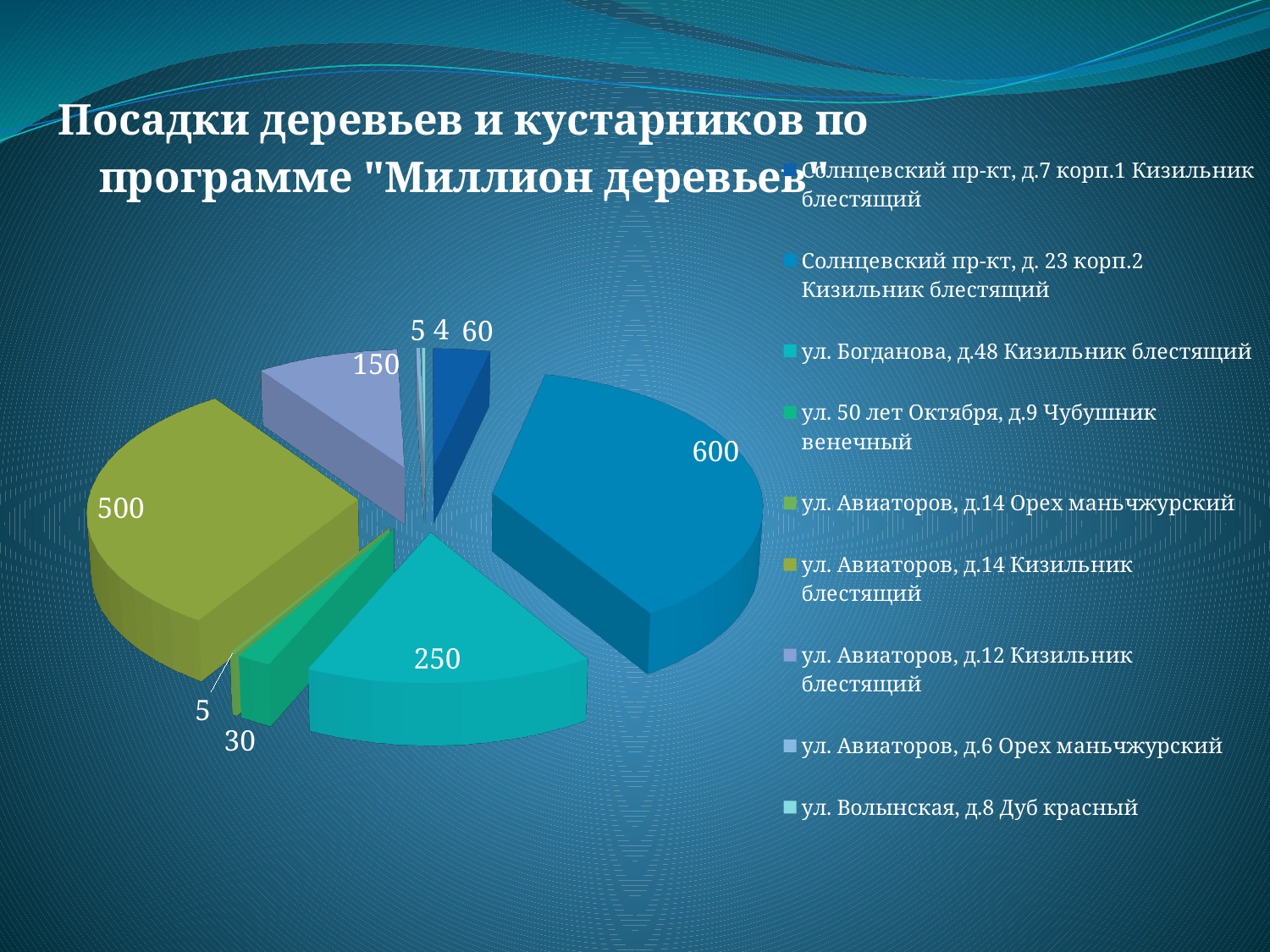
Which category has the smallest value? ул. Волынская, д.8 Дуб красный Which category has the largest slice? Солнцевский пр-кт, д. 23 корп.2 Кизильник блестящий What is the value for ул. Авиаторов, д.14 Кизильник блестящий? 500 What is the title of the slide? Посадки деревьев и кустарников по программе "Миллион деревьев" What is the value for ул. Авиаторов, д.12 Кизильник блестящий? 150 What is the value for Солнцевский пр-кт, д.7 корп.1 Кизильник блестящий? 60 Which is larger: the value for ул. Богданова, д.48 Кизильник блестящий or the value for ул. Авиаторов, д.12 Кизильник блестящий? ул. Богданова, д.48 Кизильник блестящий What kind of chart is shown on the slide? pie chart How many entries does the legend list? 9 How many slices does the pie chart have? 9 What is the difference between the values for Солнцевский пр-кт, д. 23 корп.2 Кизильник блестящий and ул. Авиаторов, д.14 Кизильник блестящий? 100 What is the value for ул. Богданова, д.48 Кизильник блестящий? 250